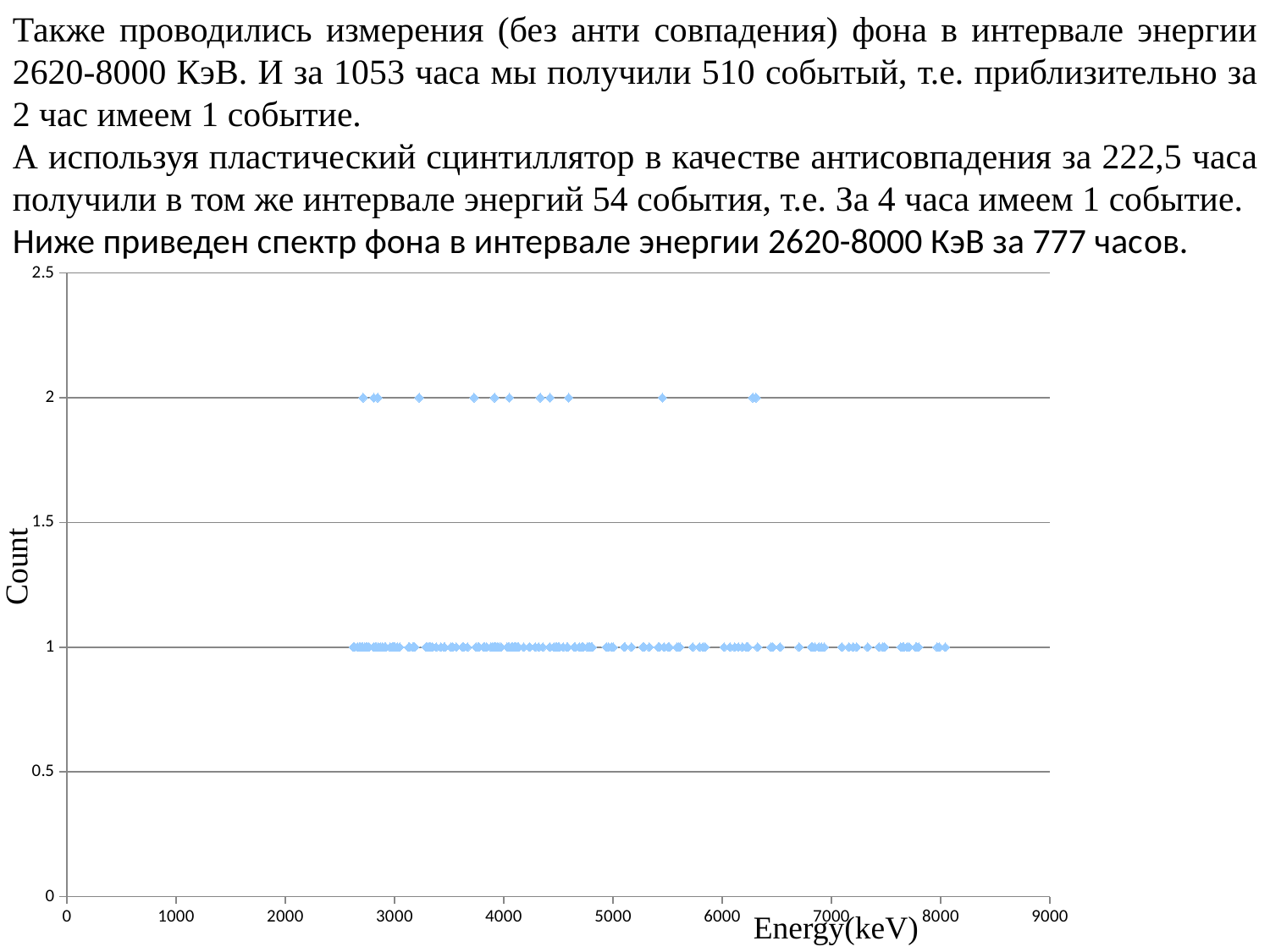
Are the points with Count 2 greater or less than 1.5 on the vertical axis? greater What kind of chart is shown on the slide? scatter chart Is the energy of the rightmost plotted point greater or less than 9000 keV? less What is the difference between the highest and lowest Count values at which points are plotted? 1 What is the maximum value shown on the horizontal (Energy) axis? 9000 What is the lowest Count value at which points are plotted on the chart? 1 What is the highest Count value reached by any point on the chart? 2 What is the maximum value shown on the vertical (Count) axis? 2.5 Is the energy of the leftmost plotted point greater or less than 2000 keV? greater What is the label of the vertical axis of the chart? Count What is the label of the horizontal axis of the chart? Energy(keV) Are there more plotted points at Count 1 or at Count 2? Count 1